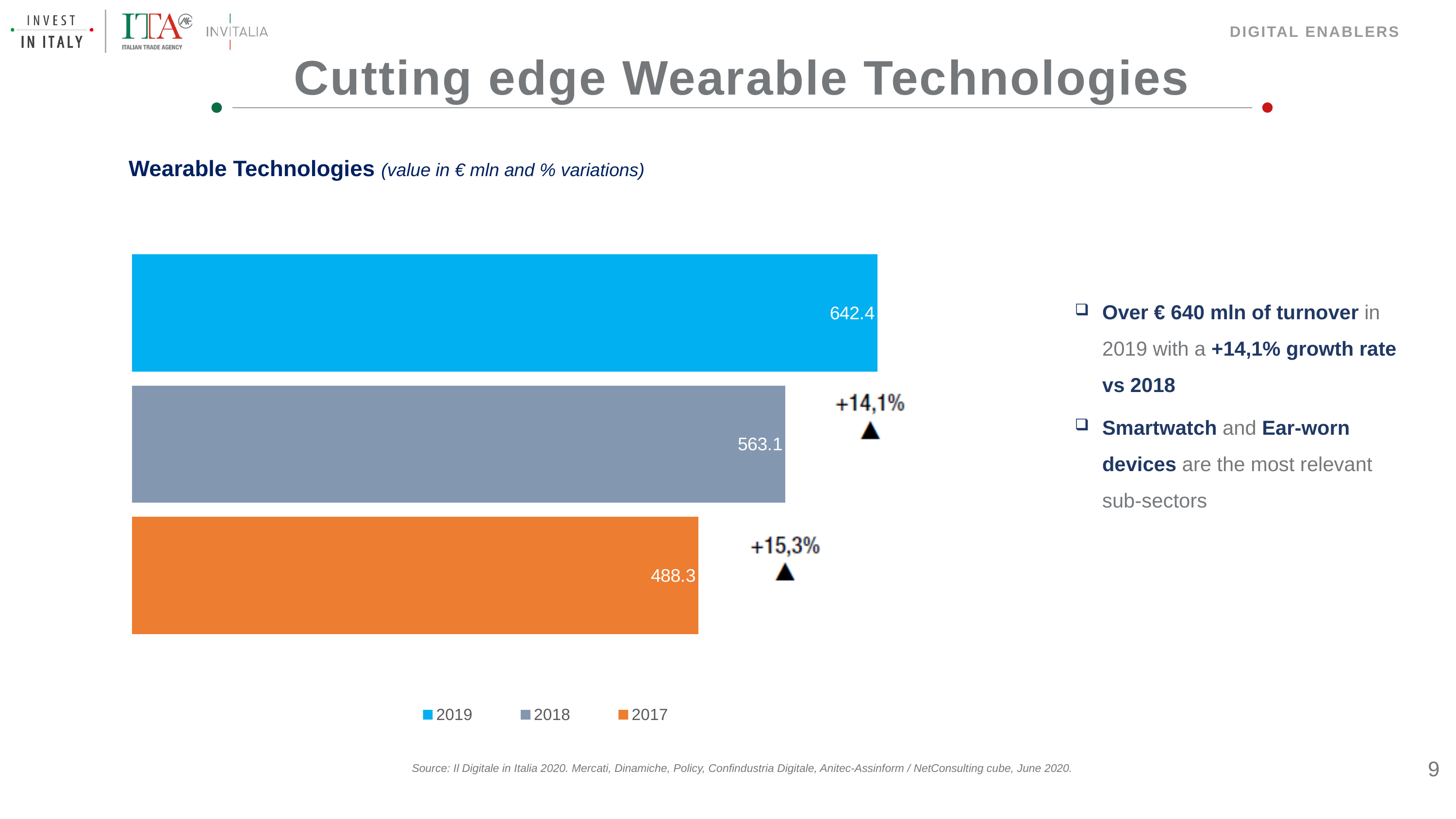
What percentage variation is shown between 2018 and 2019 in the Wearable Technologies chart? +14,1% What is the value for 2018 in the Wearable Technologies chart? 563.1 What kind of chart is used for Wearable Technologies? Bar chart What colour is the bar for 2017 in the Wearable Technologies chart? Orange What is the difference between the 2019 and 2018 values in the Wearable Technologies chart? 79.3 What is the difference between the 2018 and 2017 values in the Wearable Technologies chart? 74.8 How many series does the legend of the Wearable Technologies chart list? 3 Which year has the highest value in the Wearable Technologies chart? 2019 Which year has the lowest value in the Wearable Technologies chart? 2017 What is the value for 2019 in the Wearable Technologies chart? 642.4 Which is larger in the Wearable Technologies chart, the value for 2018 or the value for 2017? 2018 What is the value for 2017 in the Wearable Technologies chart? 488.3